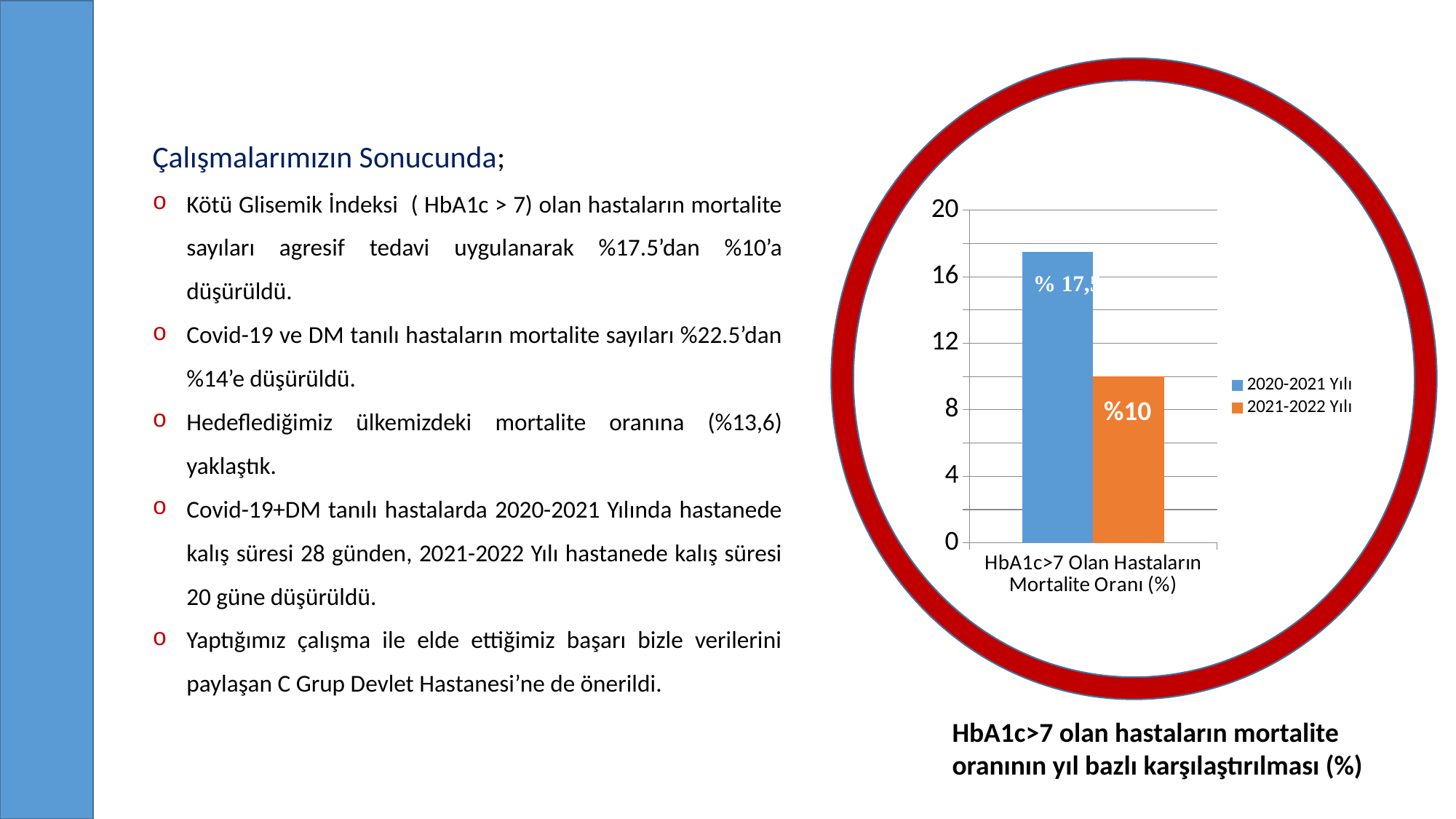
What is the value of the 2020-2021 Yılı bar in the chart? % 17,5 Which series has the higher mortality rate in the chart, 2020-2021 Yılı or 2021-2022 Yılı? 2020-2021 Yılı What colour is the bar for 2021-2022 Yılı in the chart? orange How many series does the chart legend list? 2 What are the two series listed in the chart legend? 2020-2021 Yılı and 2021-2022 Yılı Is the value for 2020-2021 Yılı greater or less than 16? greater Which series has the lowest value in the chart? 2021-2022 Yılı What is the category label on the x axis of the chart? HbA1c>7 Olan Hastaların Mortalite Oranı (%) What kind of chart is shown on the slide? bar chart What is the value of the 2021-2022 Yılı bar in the chart? %10 How many categories are shown on the x axis of the chart? 1 Is the value for 2021-2022 Yılı greater or less than 12? less